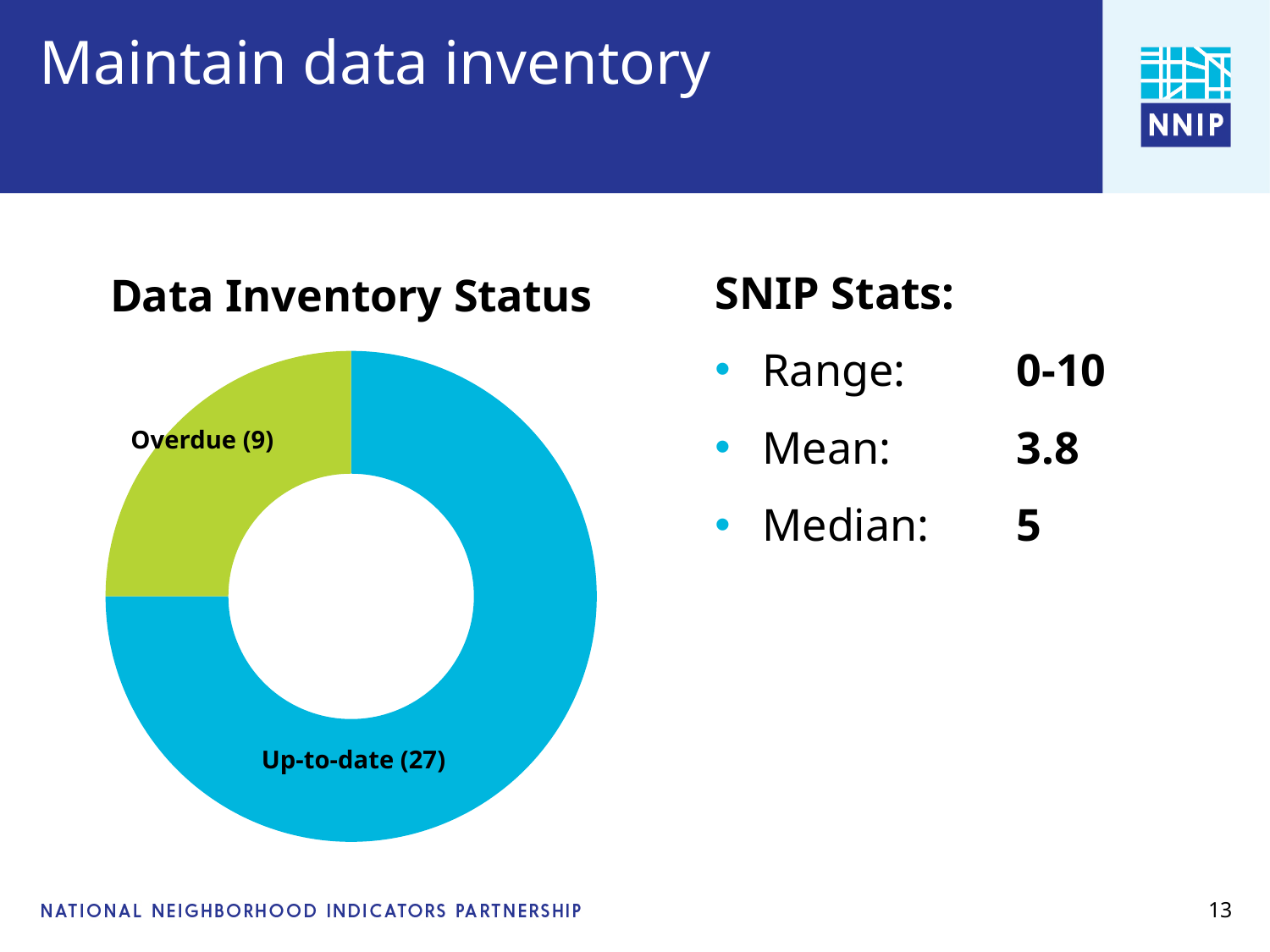
What is the total of all categories in the chart? 36 Which category has the smallest value? Overdue What kind of chart is shown on the slide? doughnut chart What is the difference between the Up-to-date and Overdue values? 18 How many categories does the chart show? 2 What share of the chart does Overdue represent? 25% Which is larger, Up-to-date or Overdue? Up-to-date What is the value for Up-to-date? 27 What is the title of the chart? Data Inventory Status What colour is the Overdue segment? green What is the value for Overdue? 9 Which category has the largest value? Up-to-date